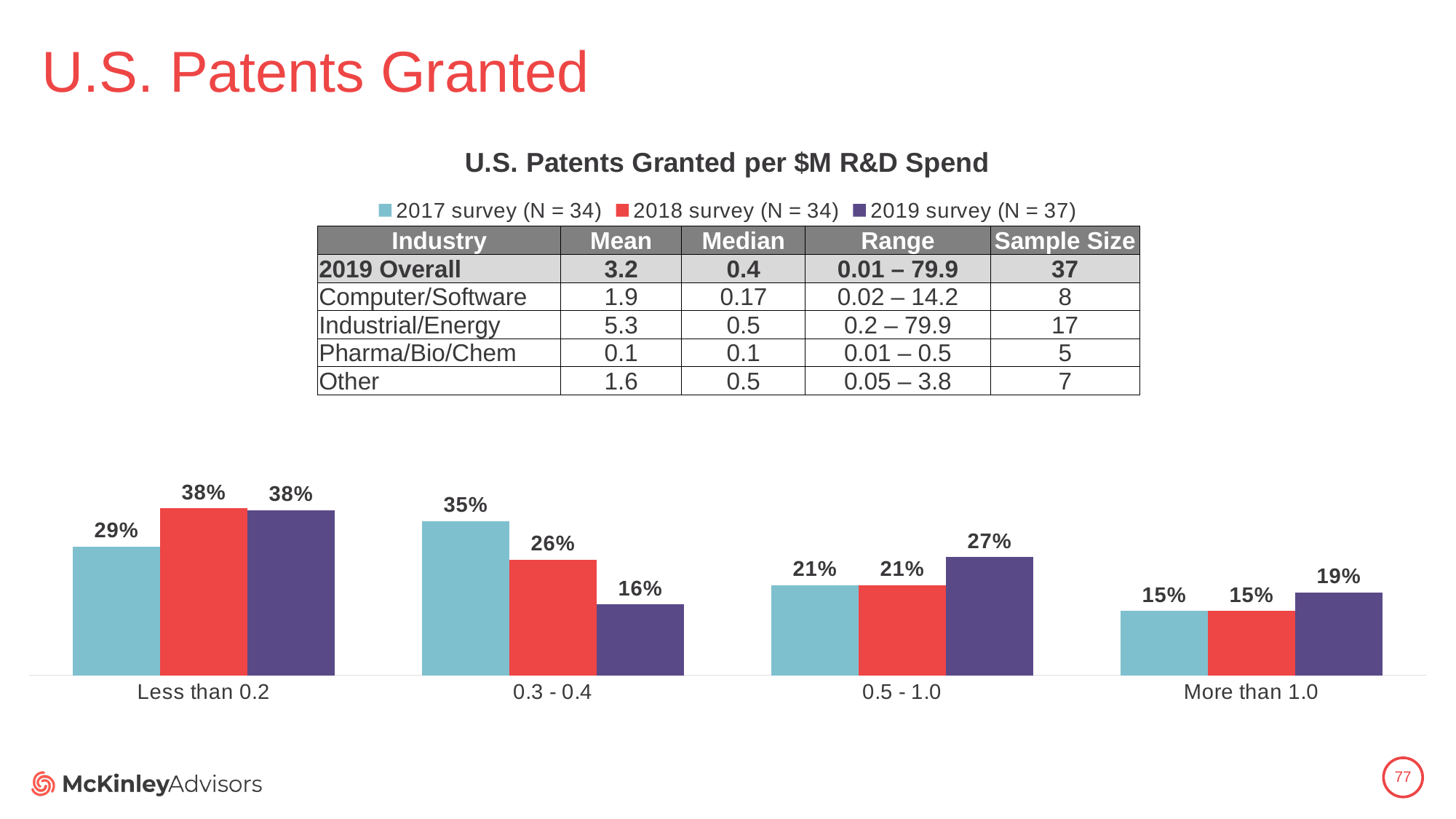
In the '0.5 - 1.0' category, which is larger: the 2017 survey value or the 2019 survey value? 2019 survey How many series does the chart legend list? 3 What is the value for the 2018 survey in the 'More than 1.0' category? 15% Which category has the highest value for the 2019 survey? Less than 0.2 What is the value for the 2019 survey in the 'Less than 0.2' category? 38% Do the 2017 survey values rise or fall from 'Less than 0.2' to 'More than 1.0'? Neither consistently: they rise from 29% to 35%, then fall to 21% and 15% What kind of chart is shown on the slide? Bar chart What is the value for the 2017 survey in the '0.3 - 0.4' category? 35% What is the title of the chart? U.S. Patents Granted per $M R&D Spend How many categories are shown on the x axis of the chart? 4 What is the difference between the 2018 survey and 2019 survey values in the '0.3 - 0.4' category? 10% Which category has the lowest value for the 2017 survey? More than 1.0